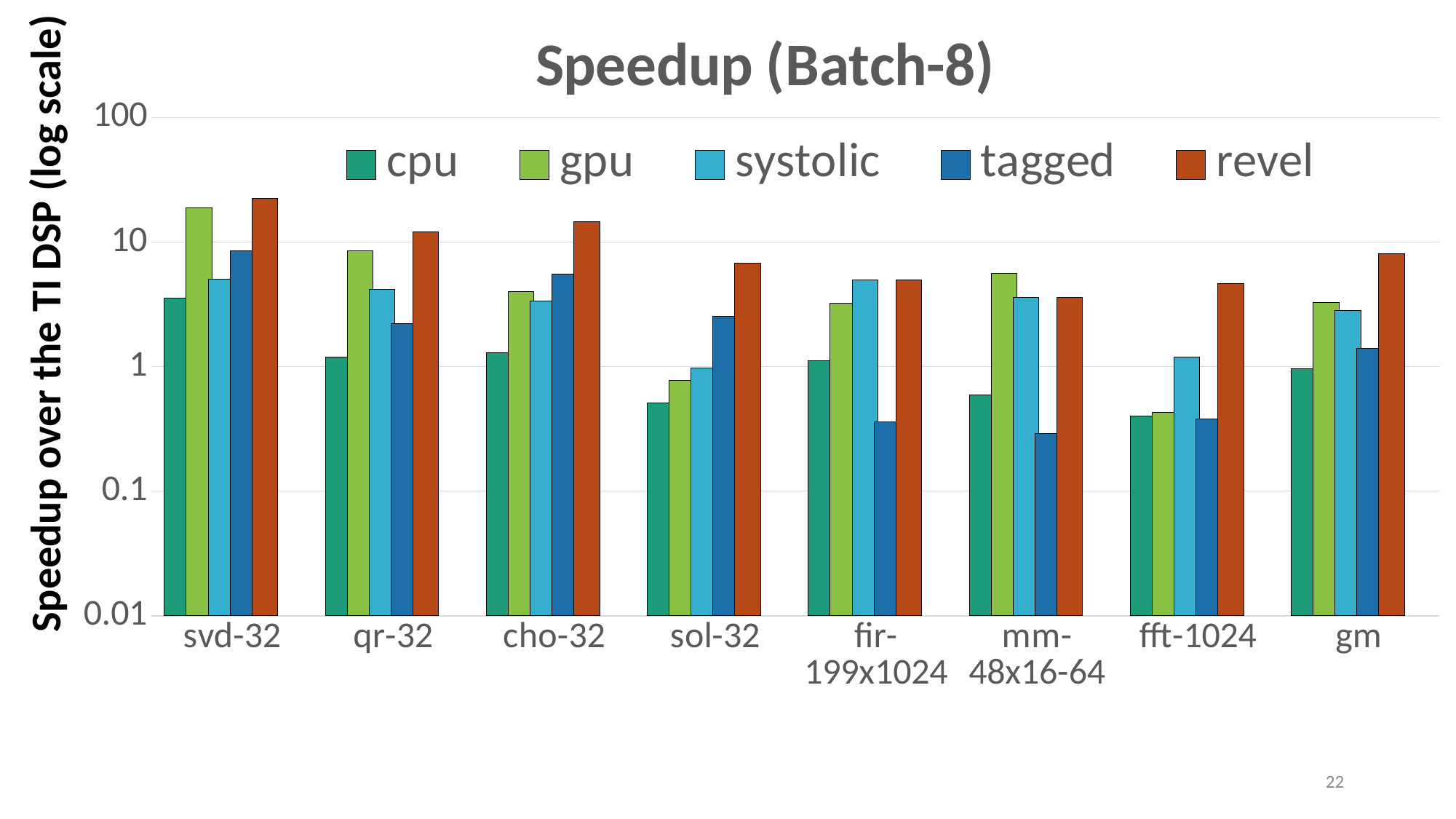
Is the cpu value for sol-32 greater or less than 1? less Is the tagged value for fir-199x1024 greater or less than 1? less What is the label of the y axis? Speedup over the TI DSP (log scale) How many series does the legend list? 5 For mm-48x16-64, which series has the lowest value? tagged Is the revel value for svd-32 greater or less than 10? greater What kind of chart is shown on the slide? bar chart For which category is the revel bar the highest? svd-32 What is the title of the chart? Speedup (Batch-8) For cho-32, which series has the highest value? revel How many categories are shown along the x axis? 8 For sol-32, which is larger: the tagged value or the cpu value? tagged